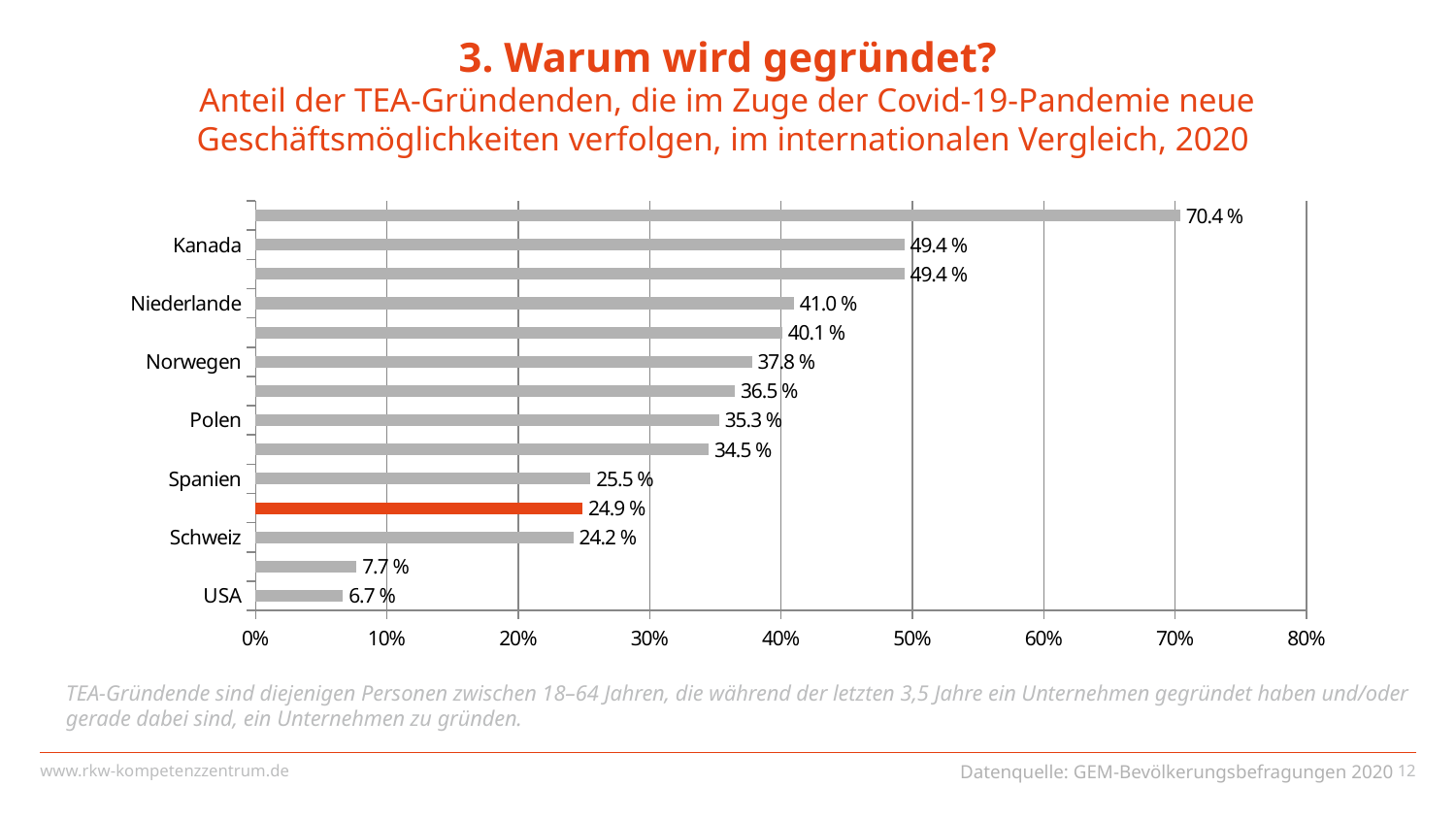
Is the value for Polen greater or less than 30%? greater What is the value for Niederlande? 41.0 % What is the value for Kanada? 49.4 % How many bars are plotted on the chart? 14 Which labelled country has the lowest value? USA What is the difference between the values for Kanada and USA? 42.7 % Which is larger, the value for Niederlande or the value for Norwegen? Niederlande What is the highest value shown on the chart? 70.4 % What is the value for USA? 6.7 % What is the value of the orange highlighted bar? 24.9 % What is the value for Schweiz? 24.2 % What kind of chart is shown on the slide? bar chart